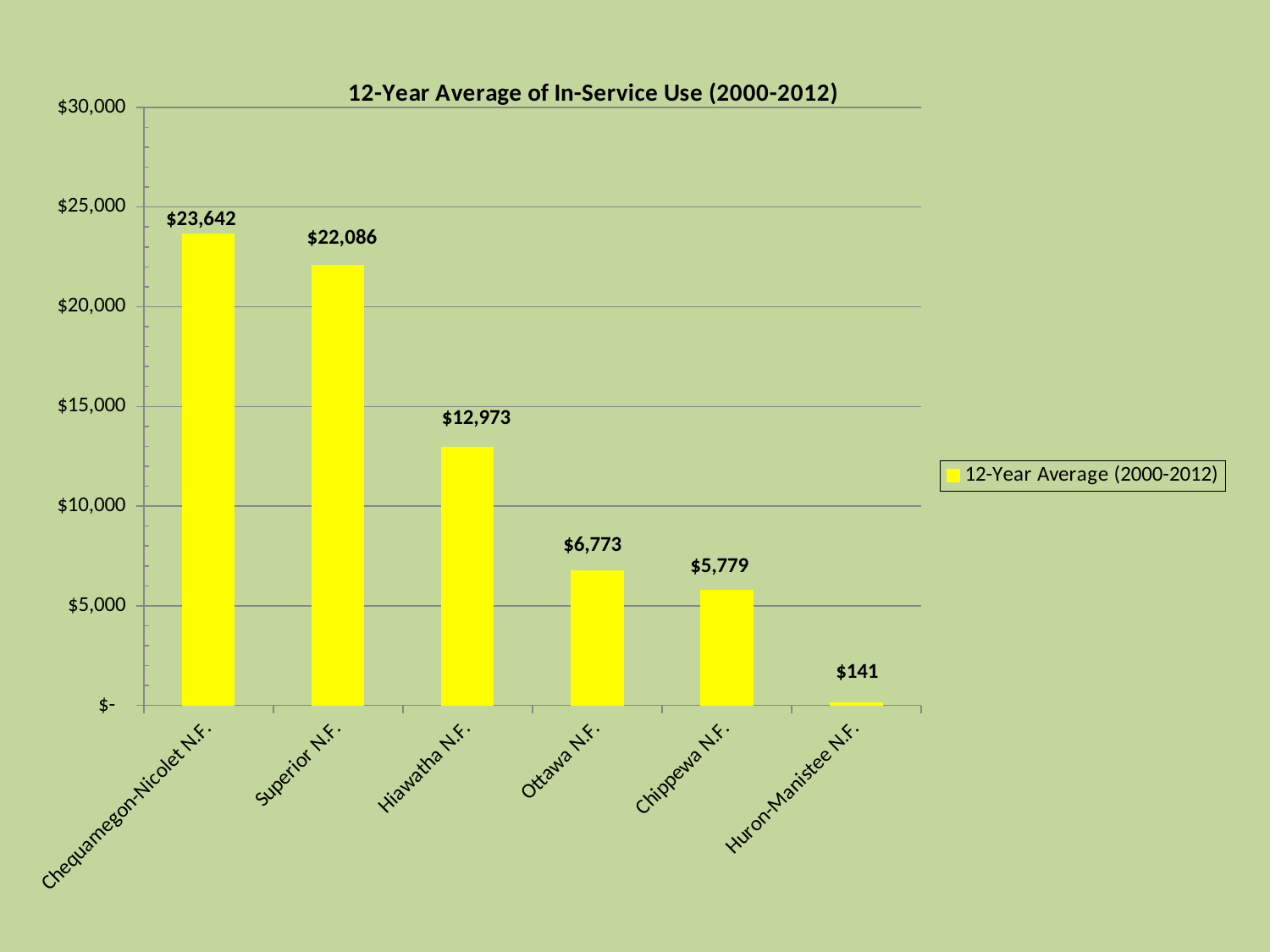
Is the value for Chippewa N.F. greater or less than $10,000? less What is the title of the chart? 12-Year Average of In-Service Use (2000-2012) What is the 12-year average in-service use value for Superior N.F.? $22,086 How many national forests are shown on the chart? 6 What is the difference between the values for Chequamegon-Nicolet N.F. and Superior N.F.? $1,556 What type of chart is shown on the slide? Bar chart Which national forest has the lowest 12-year average in-service use? Huron-Manistee N.F. What is the difference between the values for Ottawa N.F. and Chippewa N.F.? $994 What is the value shown for Huron-Manistee N.F.? $141 Which has a larger value, Hiawatha N.F. or Ottawa N.F.? Hiawatha N.F. Which national forest has the highest 12-year average in-service use? Chequamegon-Nicolet N.F. What is the value shown for Hiawatha N.F.? $12,973